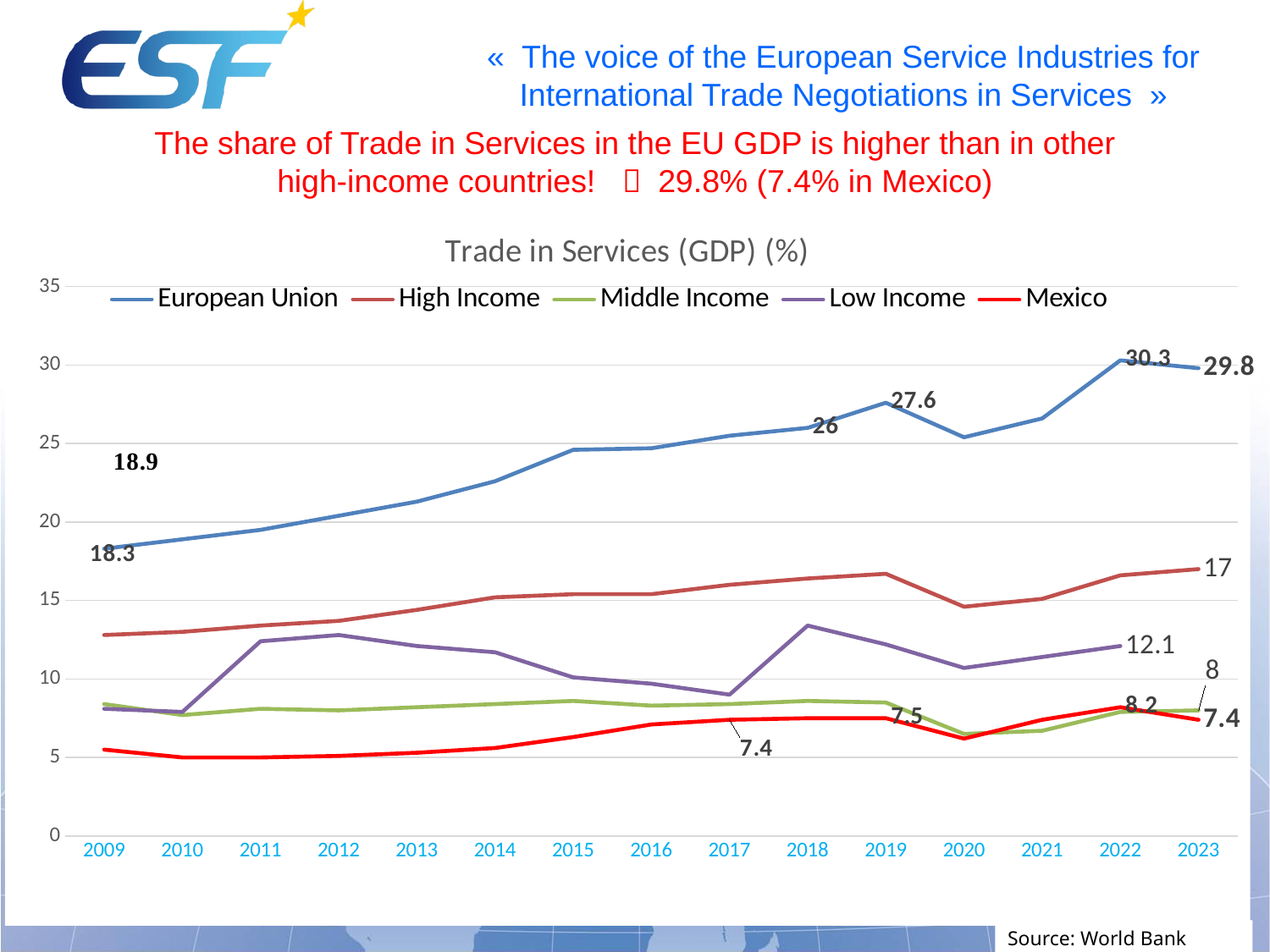
How many series does the legend of the chart list? 5 Is the value for Low Income in 2018 greater or less than 10? greater What is the value for Mexico in 2023? 7.4 Which series has the highest value in 2023? European Union What is the value for the European Union in 2023? 29.8 Does the European Union line generally rise or fall from 2009 to 2023? rise What is the value for High Income in 2023? 17 How many years are shown on the x axis of the chart? 15 What kind of chart is shown on the slide? line chart What is the difference between the European Union and Mexico values in 2023? 22.4 What is the value for the European Union in 2022? 30.3